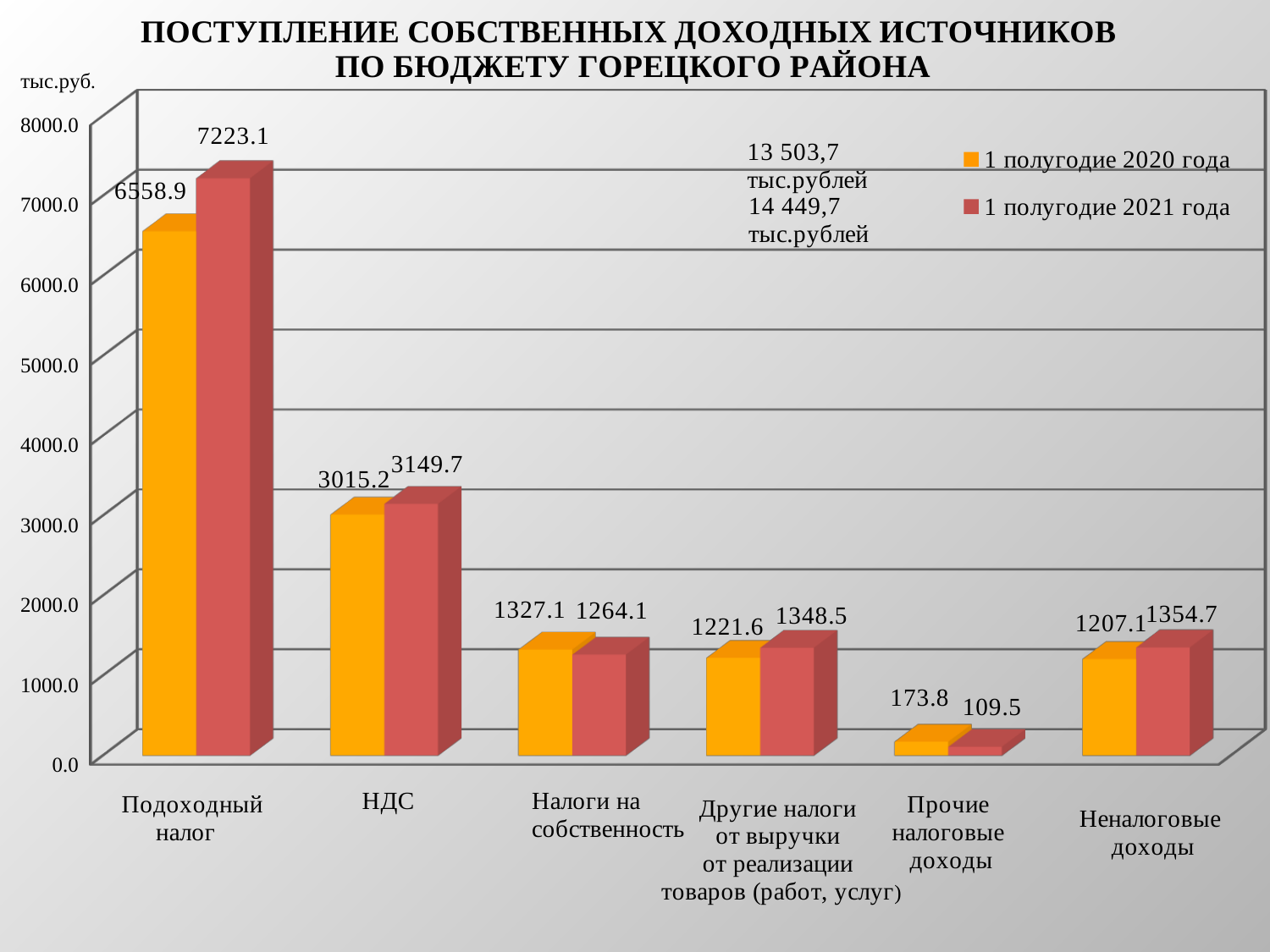
What is the difference between the 1 полугодие 2021 года and 1 полугодие 2020 года values for Подоходный налог? 664.2 For Налоги на собственность, which series has the larger value: 1 полугодие 2020 года or 1 полугодие 2021 года? 1 полугодие 2020 года How many series does the legend list? 2 What is the value for Прочие налоговые доходы in the 1 полугодие 2021 года series? 109.5 What is the value for Подоходный налог in the 1 полугодие 2021 года series? 7223.1 What unit is shown at the top of the vertical axis? тыс.руб. Which category has the lowest value in the 1 полугодие 2021 года series? Прочие налоговые доходы How many categories are shown on the x axis? 6 Which category has the highest value in the 1 полугодие 2020 года series? Подоходный налог What is the value for НДС in the 1 полугодие 2020 года series? 3015.2 Is the value for Неналоговые доходы in the 1 полугодие 2021 года series greater or less than 1000.0? greater What kind of chart is shown on the slide? bar chart